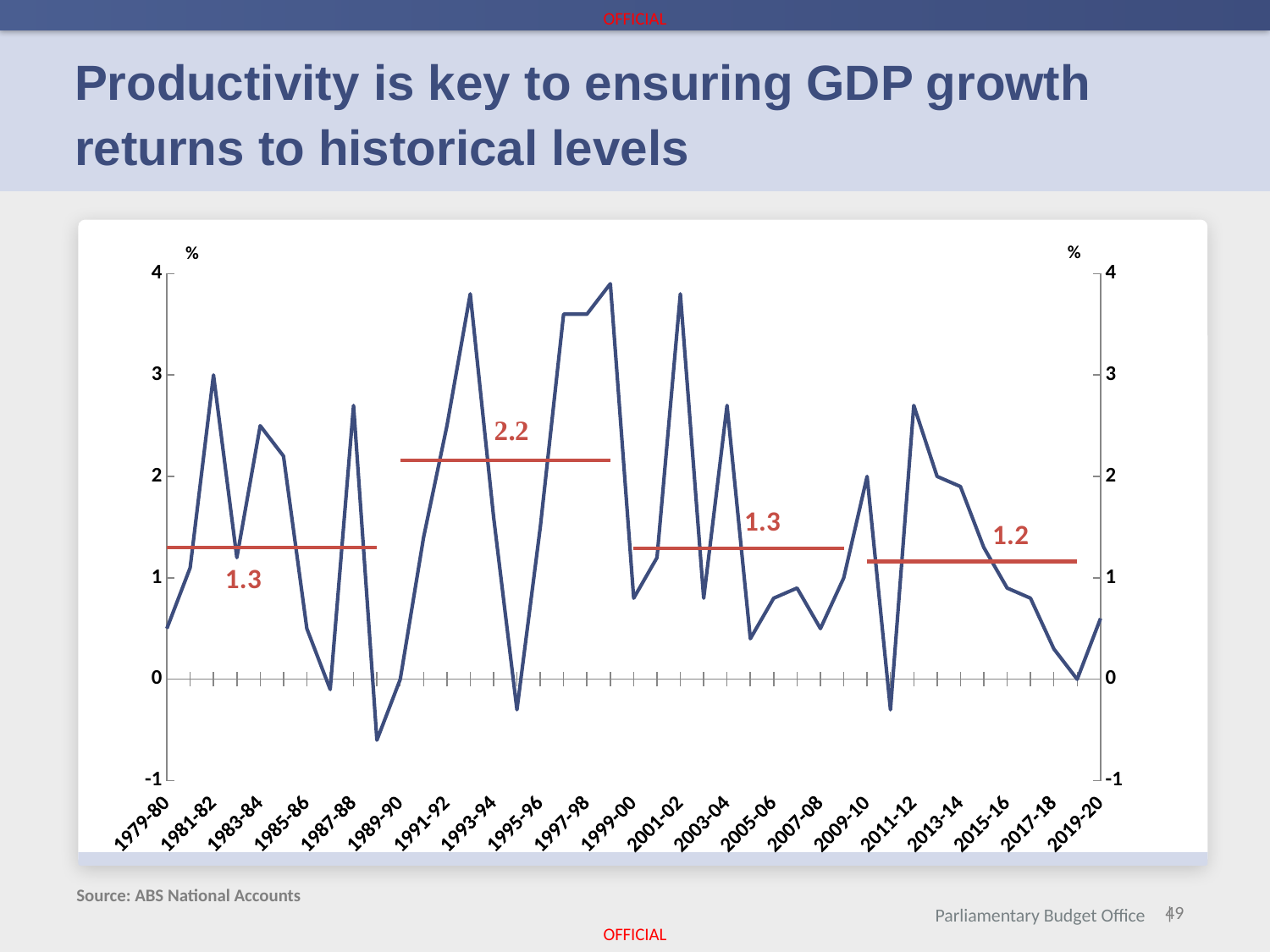
What is the source cited for the chart? ABS National Accounts Is the value for 1981-82 greater or less than 2? greater What is the value of the red average line covering the period around 1989-90 to 1999-00? 2.2 Is the value for 2019-20 greater or less than 1? less What is the value of the red average line labelled for the earliest period (around 1979-80 to 1987-88)? 1.3 What type of chart is shown on the slide? line chart Which of the red average lines has the lowest value? 1.2 Which of the red average lines has the highest value? 2.2 What is the difference between the 2.2 average line and the 1.3 average line that follows it? 0.9 What is the value of the red average line for the most recent period (around 2009-10 to 2019-20)? 1.2 How many red average lines are drawn on the chart? 4